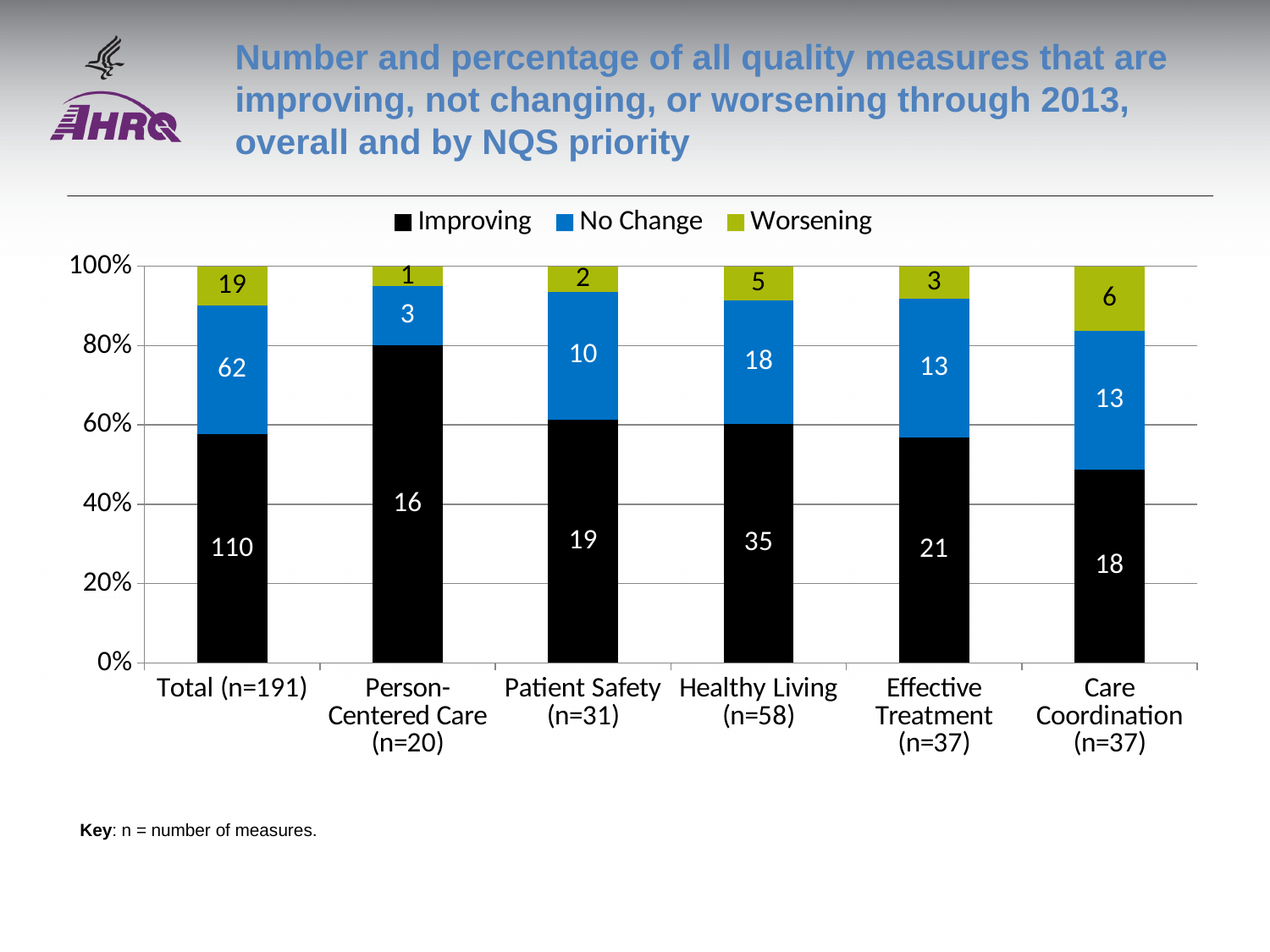
What kind of chart is shown on the slide? Stacked bar chart Which category has the lowest Worsening count? Person-Centered Care (n=20) How many quality measures are Improving in the Total (n=191) category? 110 Which is larger, the No Change count for Effective Treatment (n=37) or for Patient Safety (n=31)? Effective Treatment (n=37) How many categories are shown on the x axis? 6 What is the difference between the Improving counts for Healthy Living (n=58) and Patient Safety (n=31)? 16 Which colour represents the Worsening series? Green Is the Improving share for Person-Centered Care (n=20) greater or less than 60%? greater What is the No Change value for Healthy Living (n=58)? 18 What is the Worsening value for Care Coordination (n=37)? 6 Which category has the highest Worsening count? Total (n=191) How many series does the legend list? 3